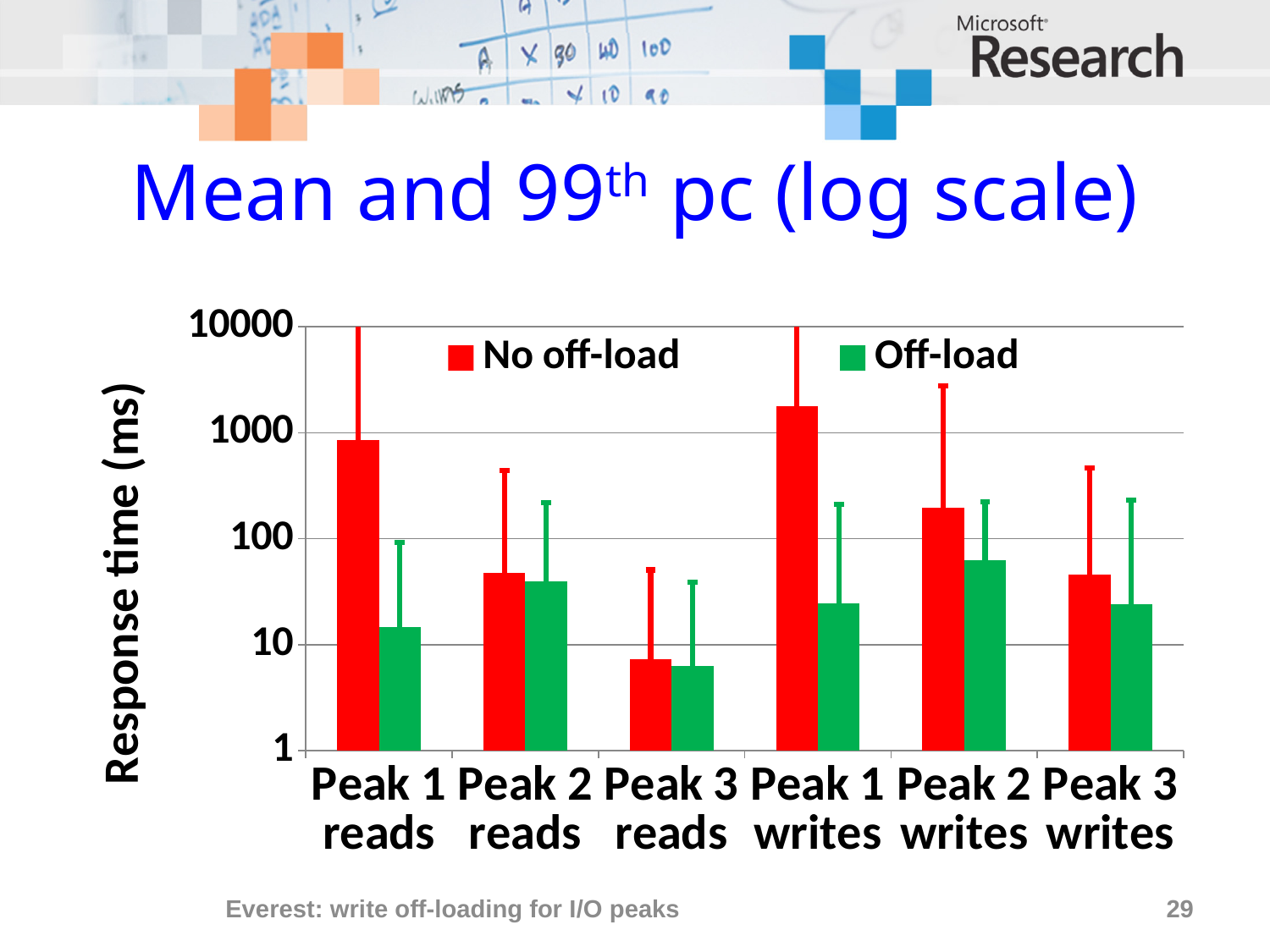
Which category has the highest No off-load response time? Peak 1 writes What kind of chart is shown on the slide? bar chart For Peak 1 reads, which is larger: the No off-load value or the Off-load value? No off-load What is the label of the y axis? Response time (ms) How many categories are shown along the x axis? 6 Which category has the highest Off-load response time? Peak 2 writes Which colour represents the Off-load series? green Is the No off-load value for Peak 1 writes greater or less than 1000? greater Is the No off-load value for Peak 1 reads greater or less than 100? greater Which category has the lowest No off-load response time? Peak 3 reads Is the Off-load value for Peak 3 reads greater or less than 10? less How many series does the legend list? 2